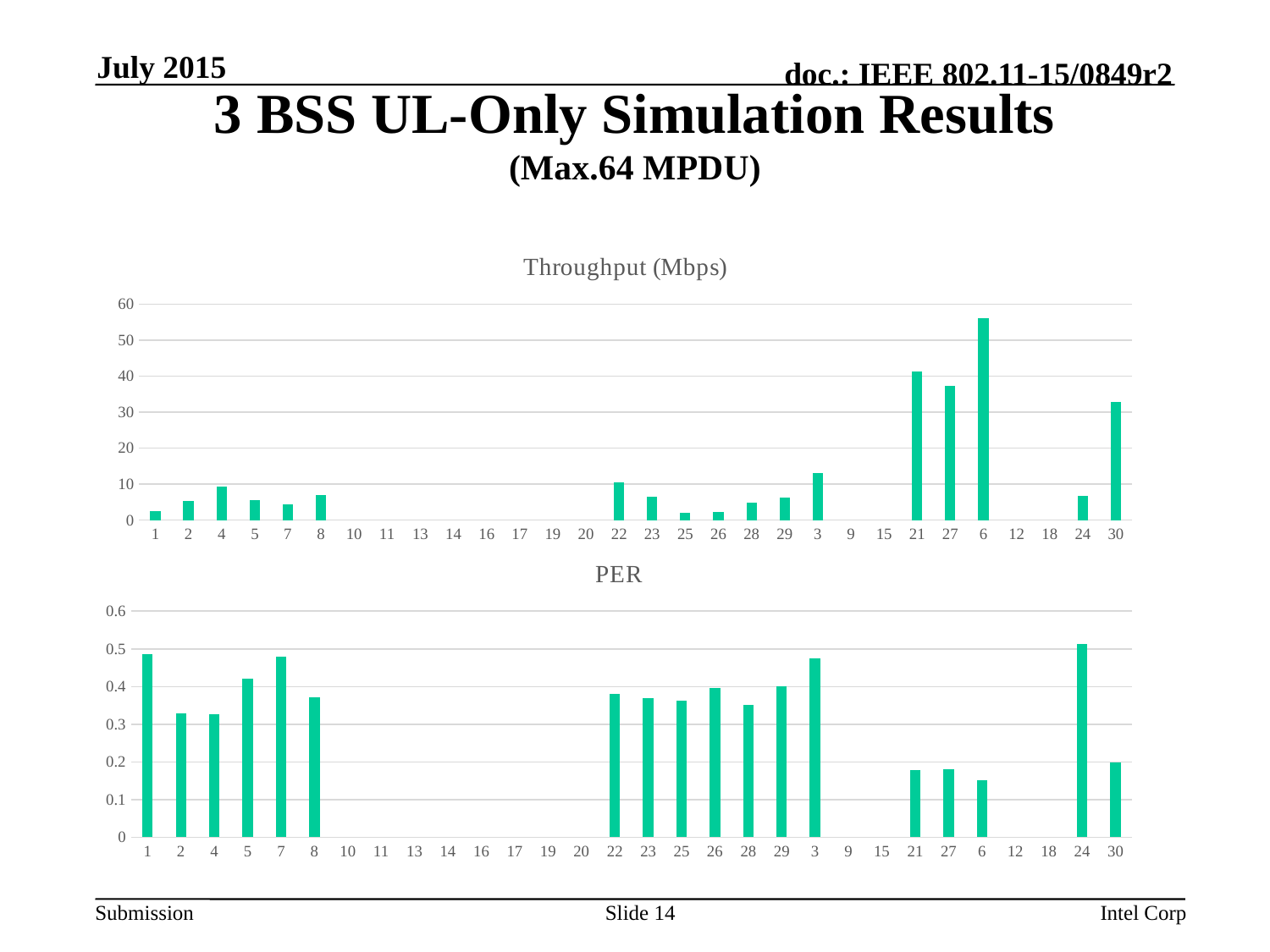
In the PER chart, which has the larger value, category 2 or category 5? 5 In the Throughput (Mbps) chart, is the value for category 21 greater or less than 40? greater In the PER chart, is the value for category 5 greater or less than 0.4? greater In the Throughput (Mbps) chart, which has the larger value, category 30 or category 6? 6 In the Throughput (Mbps) chart, which category has the highest throughput? 6 In the PER chart, is the value for category 6 greater or less than 0.2? less What kind of chart is the Throughput (Mbps) chart? bar chart In the Throughput (Mbps) chart, which has the larger value, category 21 or category 27? 21 What kind of chart is the PER chart? bar chart How many categories are shown on the x axis of the Throughput (Mbps) chart? 30